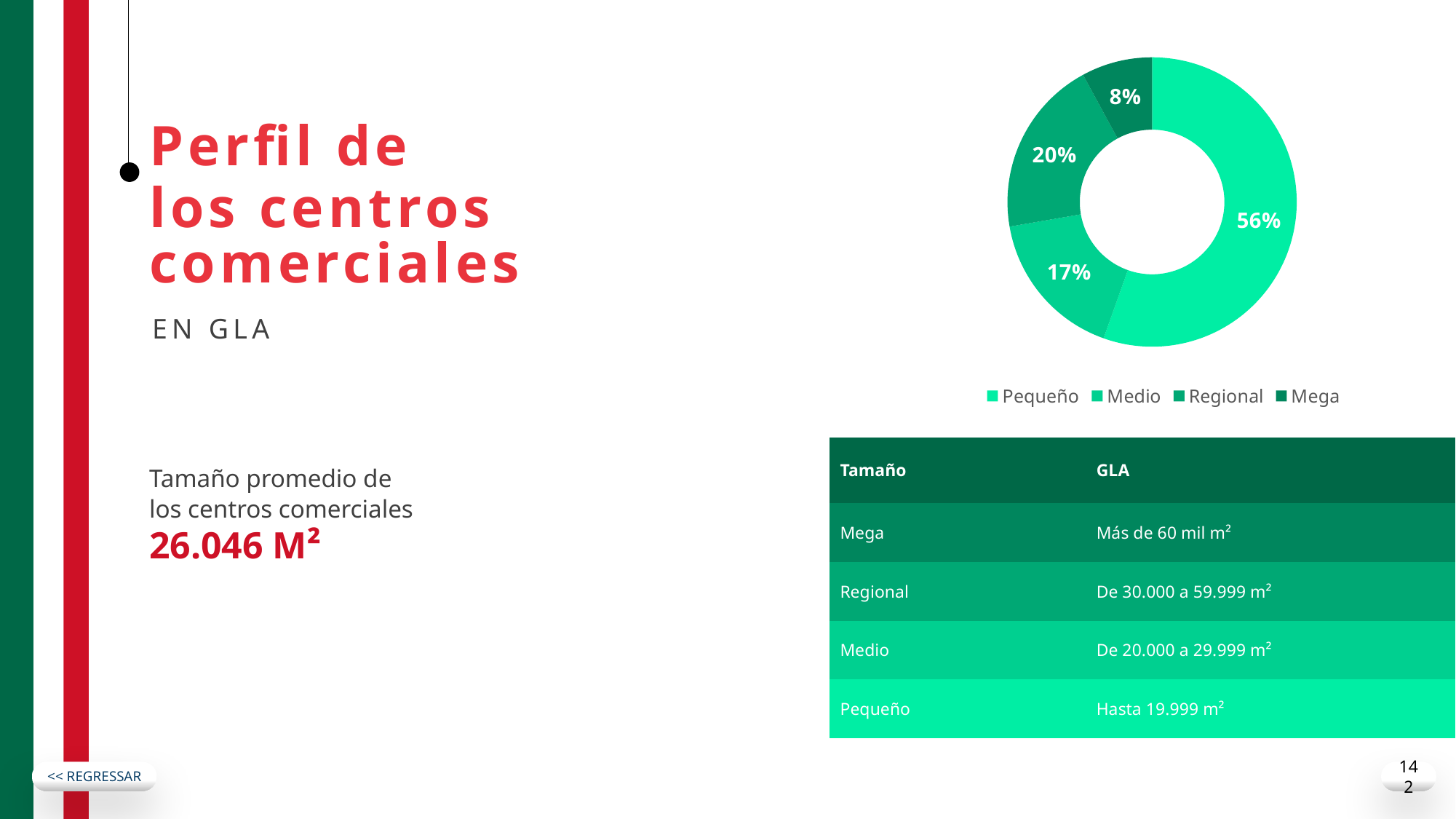
What share of the doughnut chart does Pequeño represent? 56% Which slice is larger, Regional or Medio? Regional What is the difference in percentage points between the Regional and Medio slices? 3 Which category has the largest slice in the doughnut chart? Pequeño What share of the doughnut chart does Regional represent? 20% What are the legend entries of the chart, in order? Pequeño, Medio, Regional, Mega What type of chart is shown on the slide? Doughnut chart What share of the doughnut chart does Medio represent? 17% What is the difference in percentage points between the Pequeño and Regional slices? 36 Which category has the smallest slice in the doughnut chart? Mega How many categories are shown in the doughnut chart? 4 What share of the doughnut chart does Mega represent? 8%